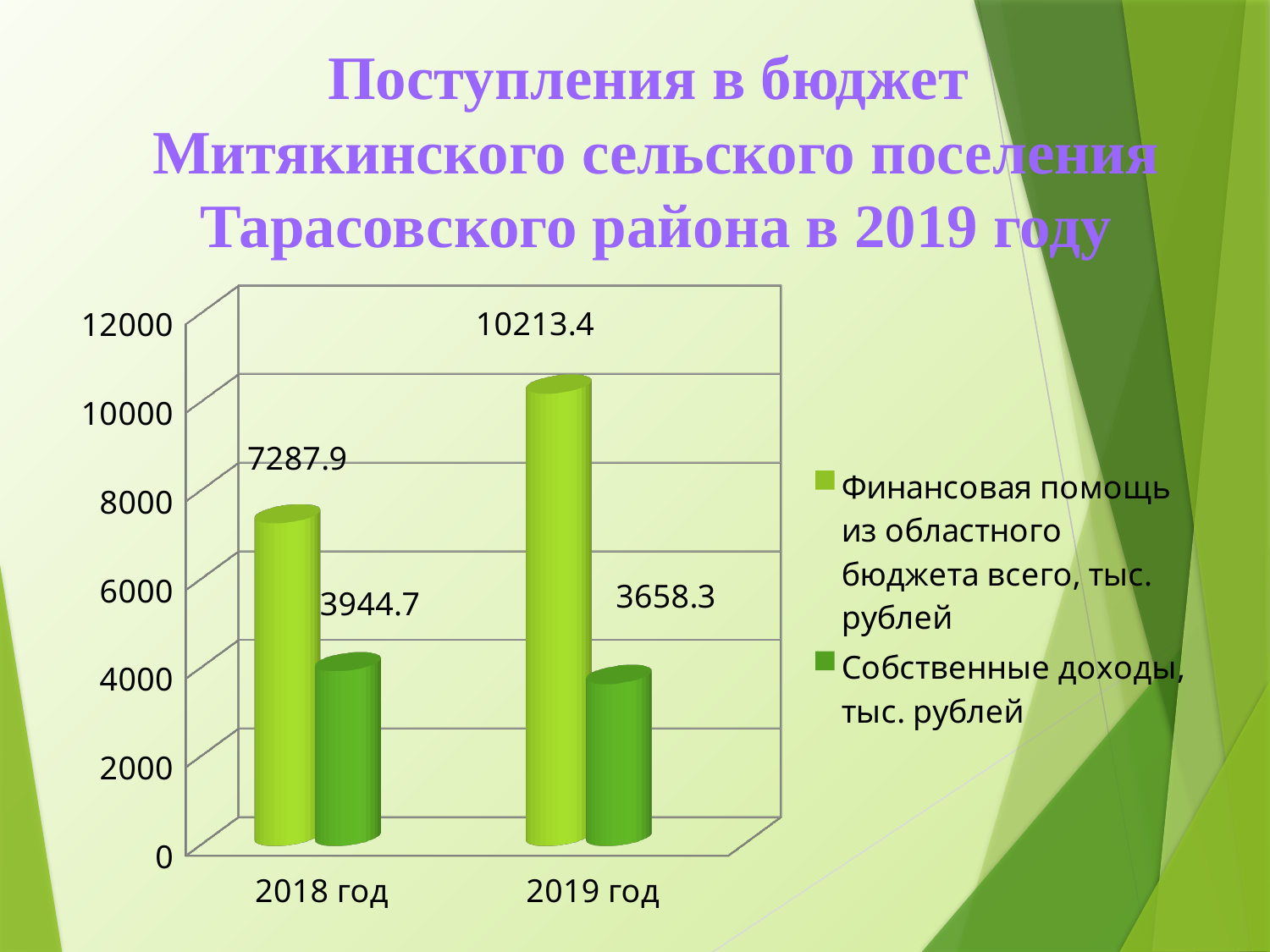
What is the value of Собственные доходы for 2018 год? 3944.7 Is the value for Собственные доходы in 2019 год greater or less than 4000? less What is the value of Финансовая помощь из областного бюджета for 2019 год? 10213.4 What is the value of Финансовая помощь из областного бюджета for 2018 год? 7287.9 Which year has the higher value for Финансовая помощь из областного бюджета? 2019 год Does Собственные доходы rise or fall from 2018 год to 2019 год? Fall Which year has the lower value for Собственные доходы? 2019 год What is the difference between Собственные доходы in 2018 год and 2019 год? 286.4 What is the value of Собственные доходы for 2019 год? 3658.3 What kind of chart is shown on the slide? Bar chart By how much did Финансовая помощь из областного бюджета increase from 2018 год to 2019 год? 2925.5 How many series does the legend list? 2